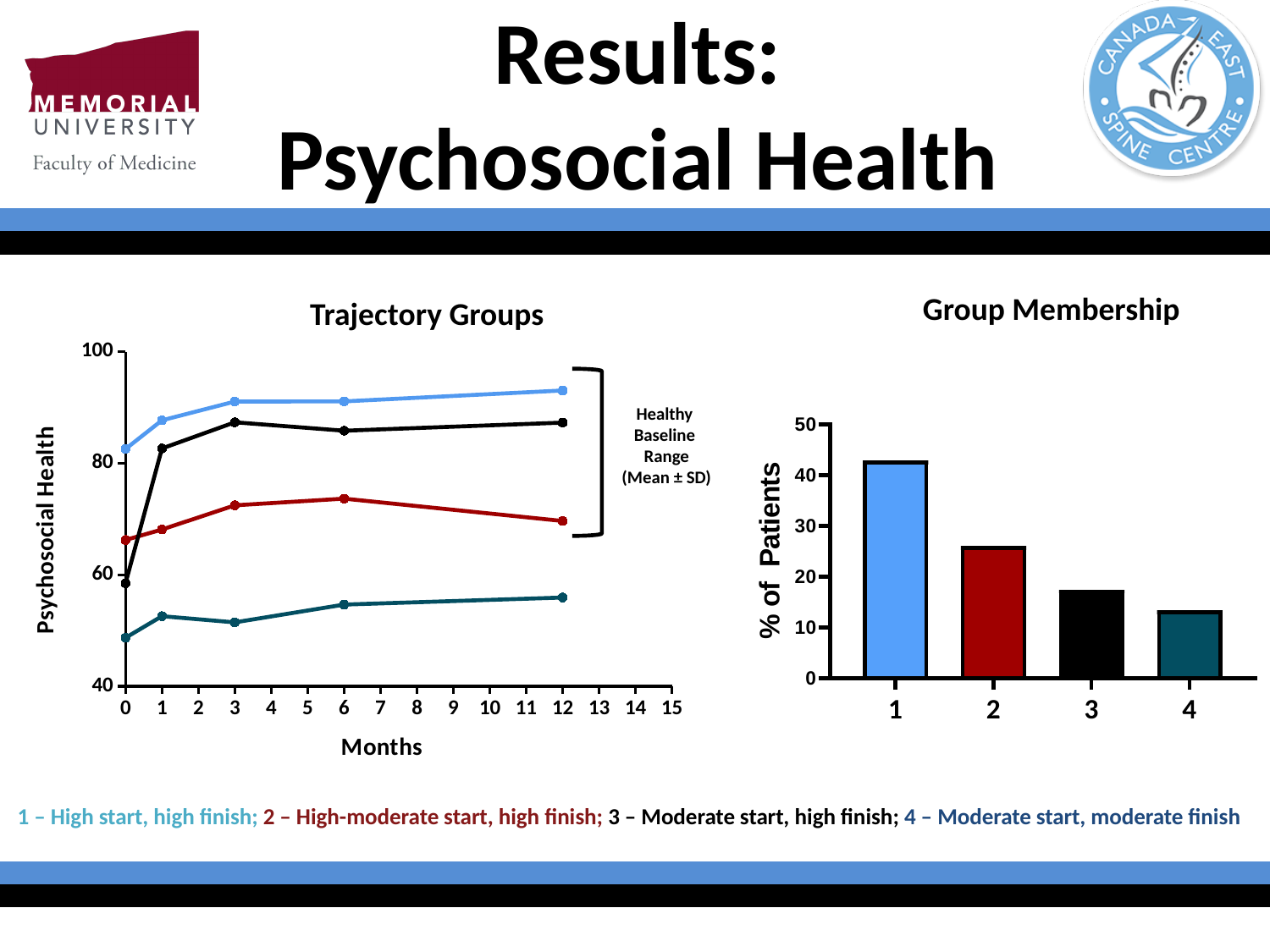
In the Group Membership chart, is the value for group 2 greater or less than 30? less What kind of chart is the Group Membership chart? bar chart In the Trajectory Groups chart, is the value of the teal line at month 0 greater or less than 60? less In the Trajectory Groups chart, what is the x-axis title? Months In the Group Membership chart, which group has the highest % of patients? 1 In the Trajectory Groups chart, how many lines are plotted? 4 In the Group Membership chart, do the values rise or fall from group 1 to group 4? fall What kind of chart is the Trajectory Groups chart? line chart In the Group Membership chart, is the value for group 1 greater or less than 40? greater In the Group Membership chart, how many bars are plotted? 4 In the Group Membership chart, which group has the lowest % of patients? 4